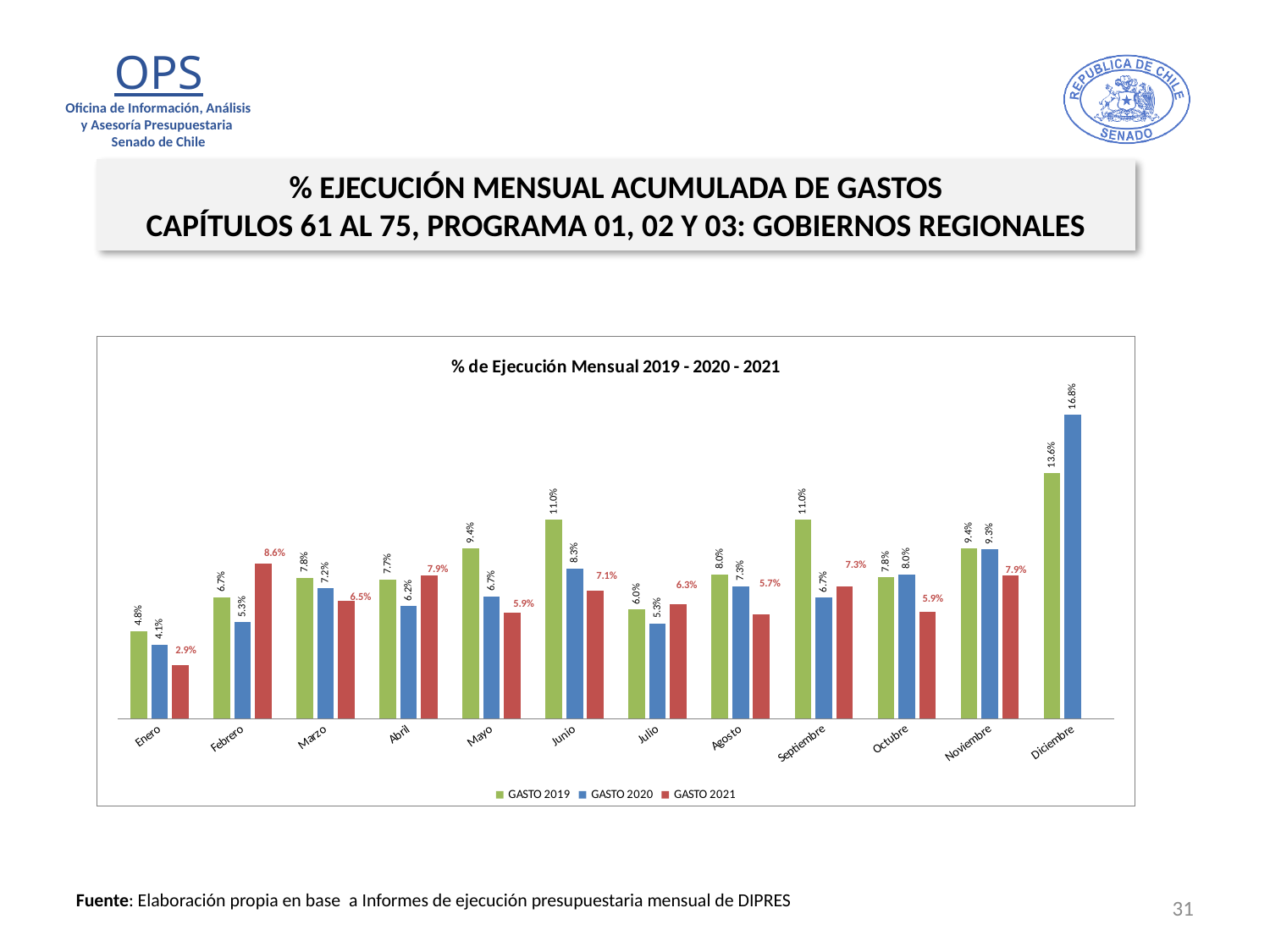
Which month has the lowest value for GASTO 2021? Enero How many months are shown on the x axis? 12 Which series has no bar for Diciembre? GASTO 2021 What is the value for GASTO 2020 in Diciembre? 16.8% What is the value for GASTO 2019 in Septiembre? 11.0% What is the title of the chart? % de Ejecución Mensual 2019 - 2020 - 2021 Which is larger in Junio, GASTO 2019 or GASTO 2020? GASTO 2019 How many series does the legend list? 3 What kind of chart is shown? Bar chart What is the difference between GASTO 2020 and GASTO 2019 in Diciembre? 3.2% What is the value for GASTO 2021 in Febrero? 8.6% Which month has the highest value for GASTO 2019? Diciembre